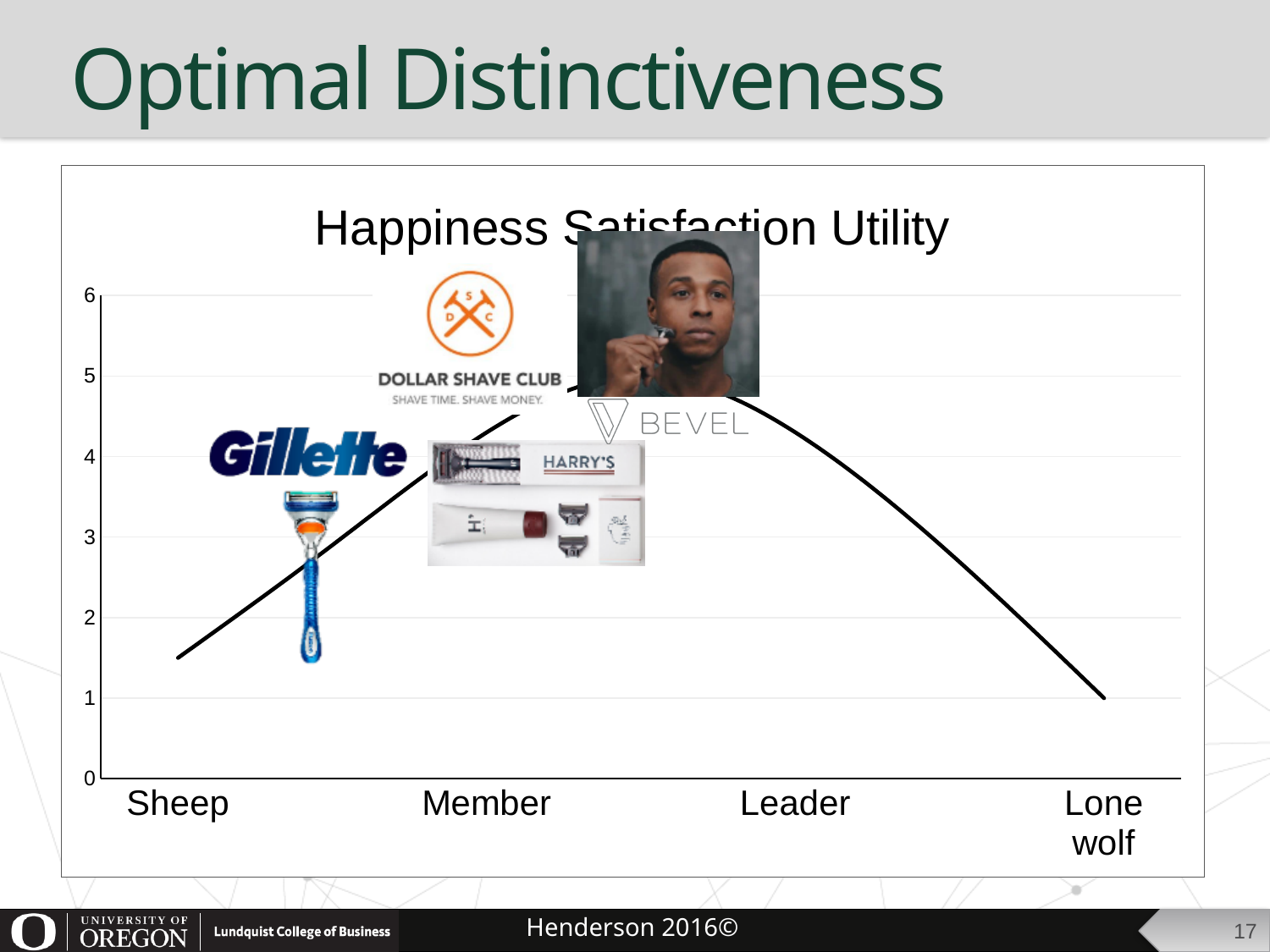
Which category is at the far right of the x axis? Lone wolf Is the value for Lone wolf greater or less than 2? less Is the value for Sheep greater or less than 2? less Is the value for Sheep greater or less than 1? greater Which has the larger value, Sheep or Leader? Leader What is the title of the chart? Happiness Satisfaction Utility How does the line change moving from Sheep to Lone wolf along the x axis? rises then falls What kind of chart is shown on the slide? line chart Which has the larger value, Member or Lone wolf? Member How many categories are shown on the x axis of the chart? 4